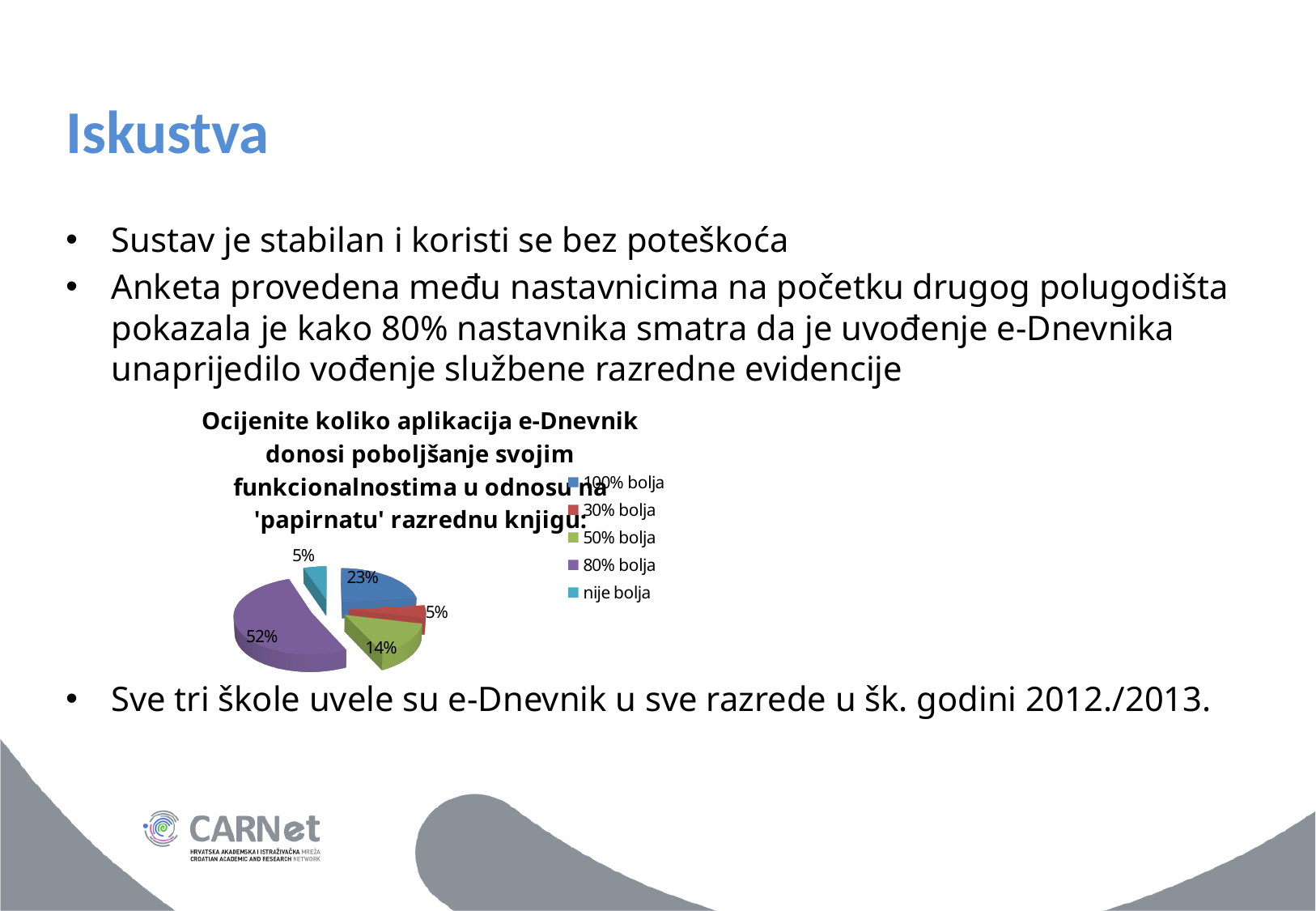
What share of the pie does the 'nije bolja' slice represent? 5% What is the difference in percentage points between the '80% bolja' slice and the '100% bolja' slice? 29 Which slice is larger, '100% bolja' or '50% bolja'? 100% bolja How many entries does the legend list? 5 What share of the pie does the '80% bolja' slice represent? 52% What share of the pie does the '30% bolja' slice represent? 5% What colour is the '80% bolja' slice in the pie chart? purple What kind of chart is shown on the slide? pie chart How many slices does the pie chart have? 5 Which category has the largest slice of the pie? 80% bolja What share of the pie does the '100% bolja' slice represent? 23% What share of the pie does the '50% bolja' slice represent? 14%